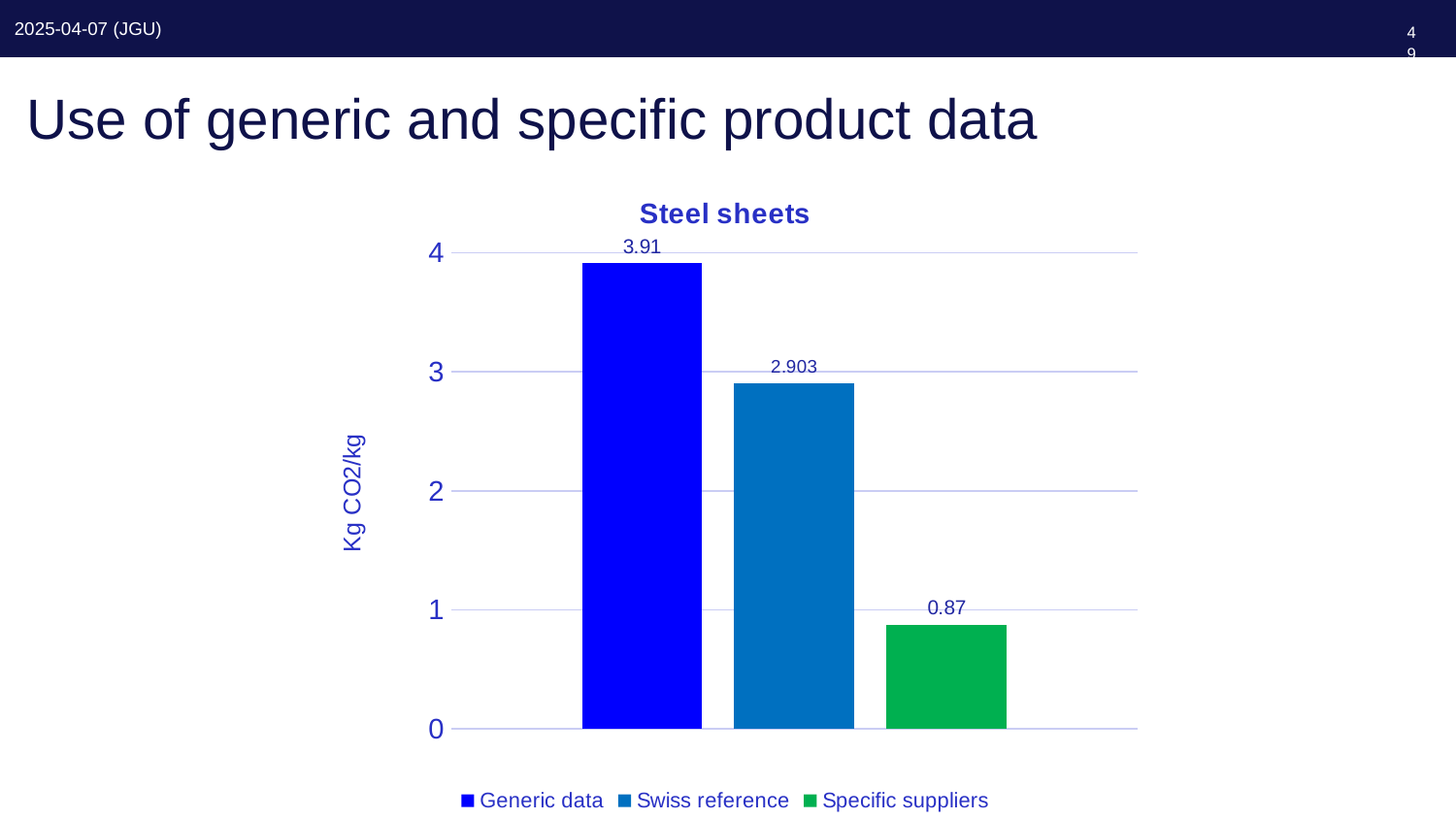
How many series does the legend list? 3 What is the label on the vertical axis of the chart? Kg CO2/kg What is the value for Generic data in the Steel sheets chart? 3.91 Which series has the highest value in the Steel sheets chart? Generic data Which is larger, the value for Swiss reference or the value for Specific suppliers? Swiss reference Which series has the lowest value in the Steel sheets chart? Specific suppliers What is the value for Swiss reference in the Steel sheets chart? 2.903 What kind of chart is shown on the slide? bar chart What is the difference between the Generic data value and the Specific suppliers value? 3.04 What is the difference between the Generic data value and the Swiss reference value? 1.007 What is the value for Specific suppliers in the Steel sheets chart? 0.87 Is the value for Swiss reference greater or less than 3? less